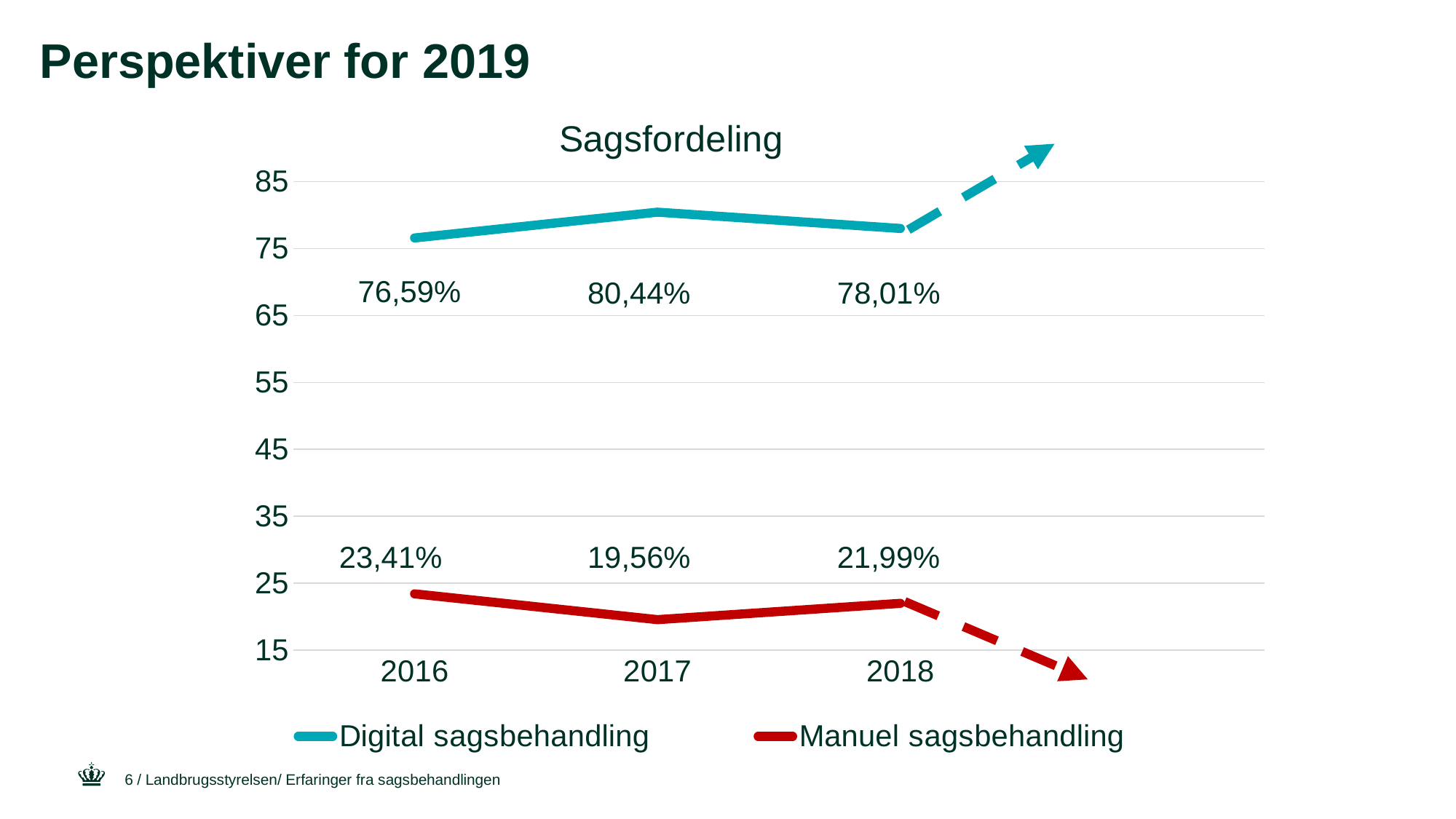
In which year is Digital sagsbehandling highest? 2017 What is the title of the chart? Sagsfordeling Which series has the larger value in 2018, Digital sagsbehandling or Manuel sagsbehandling? Digital sagsbehandling What type of chart is shown on the slide? line chart How many series does the legend list? 2 Does Manuel sagsbehandling rise or fall from 2016 to 2017? fall What is the difference between Digital sagsbehandling in 2017 and in 2016? 3,85% What is the value for Manuel sagsbehandling in 2018? 21,99% What is the value for Digital sagsbehandling in 2017? 80,44% In which year is Manuel sagsbehandling lowest? 2017 What is the value for Manuel sagsbehandling in 2016? 23,41% How many years are shown on the x axis? 3